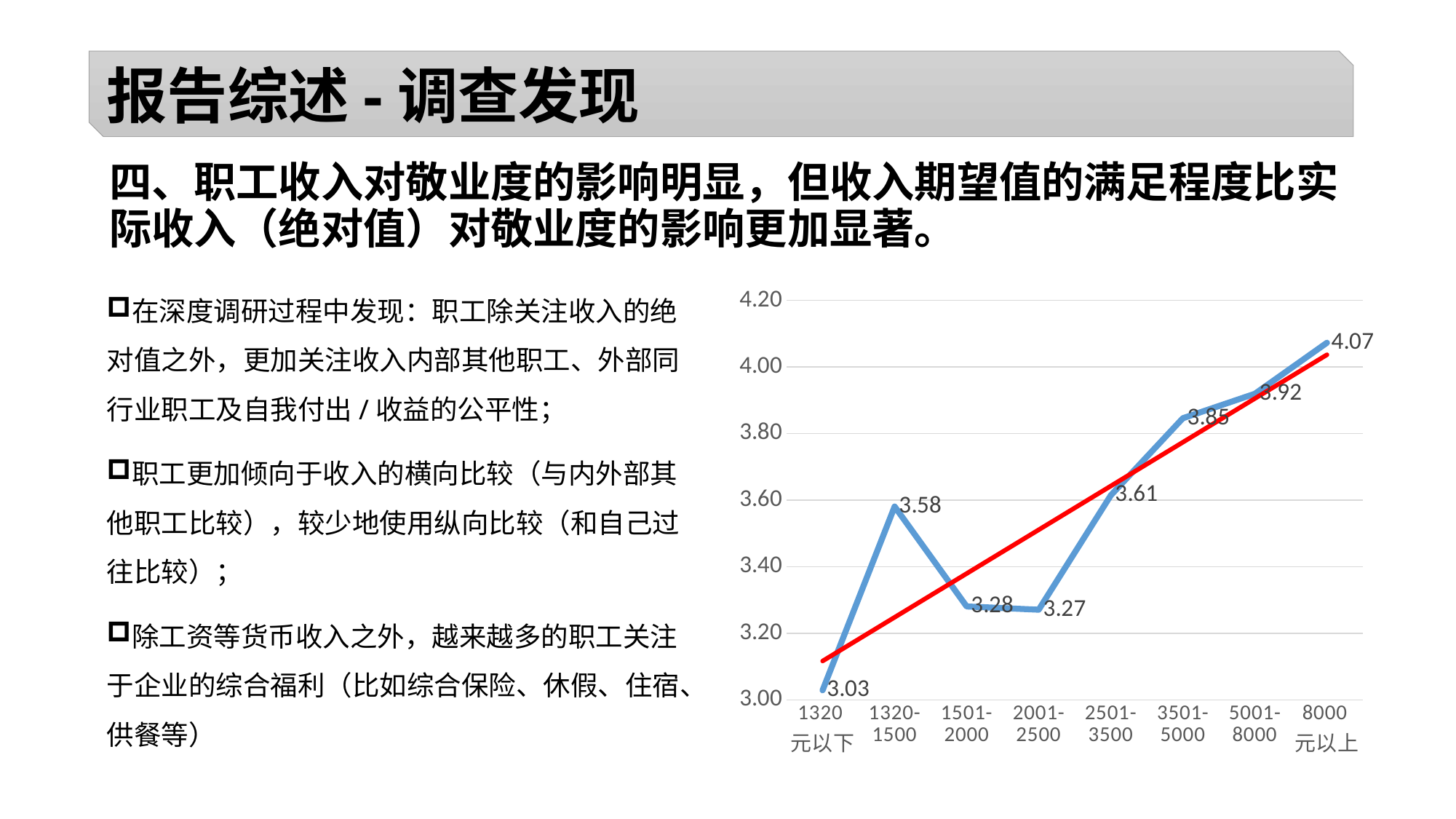
What is the value for the 1320元以下 income group? 3.03 What is the difference between the values for 8000元以上 and 1320元以下? 1.04 What is the value for the 8000元以上 income group? 4.07 What is the value for the 2501-3500 income group? 3.61 What kind of chart is shown on the slide? Line chart How many income groups are plotted on the x axis? 8 Which income group has the highest value? 8000元以上 Which income group has the lowest value? 1320元以下 What is the value for the 1320-1500 income group? 3.58 Which is larger, the value for 3501-5000 or the value for 2501-3500? 3501-5000 What is the difference between the values for 1320-1500 and 1501-2000? 0.30 What colour is the straight trend line drawn across the chart? Red